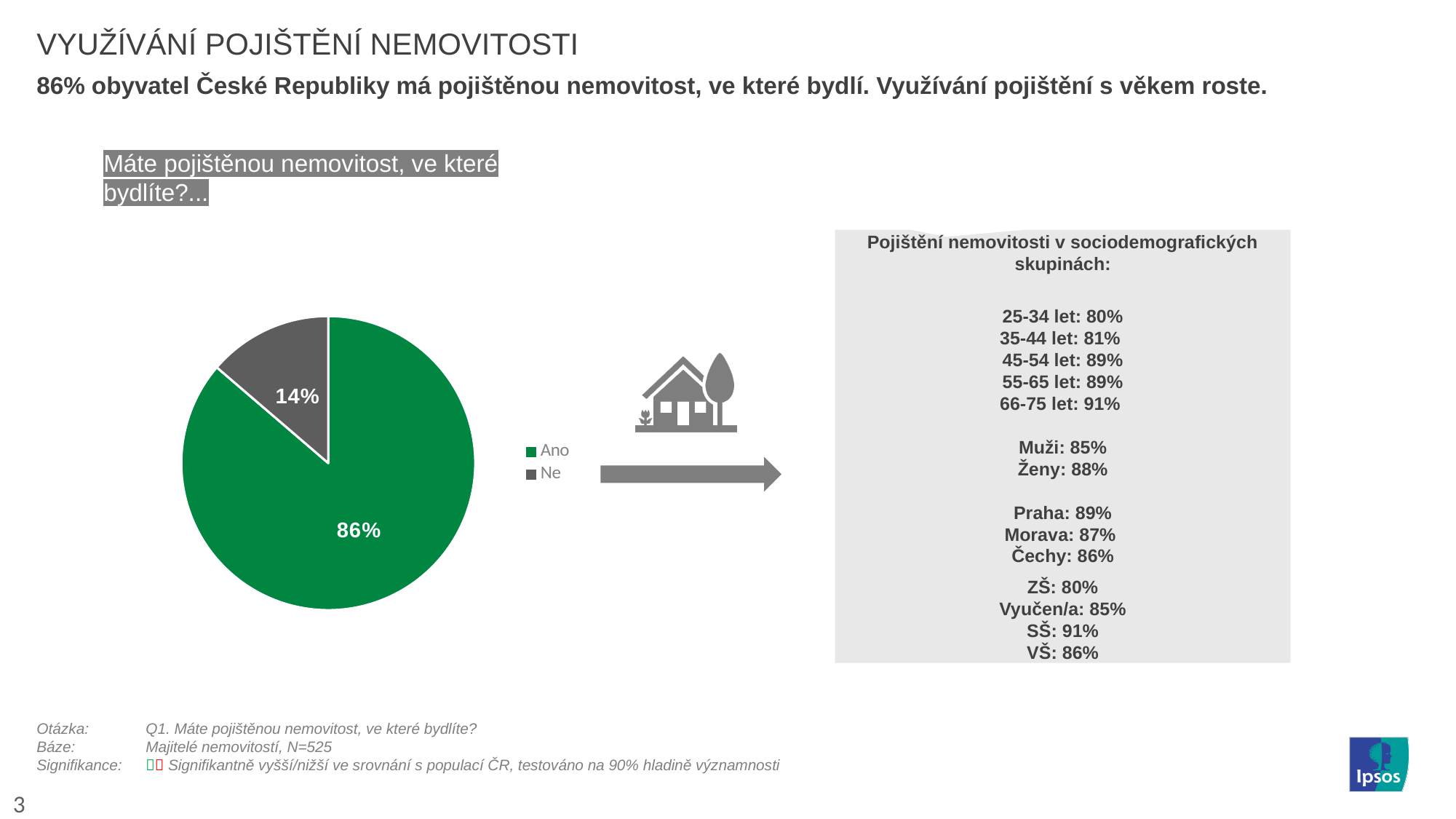
What is the difference in percentage points between the "Ano" and "Ne" slices? 72 What kind of chart is shown on the slide? pie chart Which is larger in the pie chart, "Ano" or "Ne"? Ano How many slices does the pie chart have? 2 What is the total of the two slices in the pie chart? 100% What share of the pie chart is labelled "Ne"? 14% Which slice of the pie chart is the smallest? Ne What colour is the "Ano" slice in the pie chart? green What share of the pie chart is labelled "Ano"? 86% Which slice of the pie chart is the largest? Ano How many entries does the legend of the pie chart list? 2 What is the title of the pie chart? Máte pojištěnou nemovitost, ve které bydlíte?...